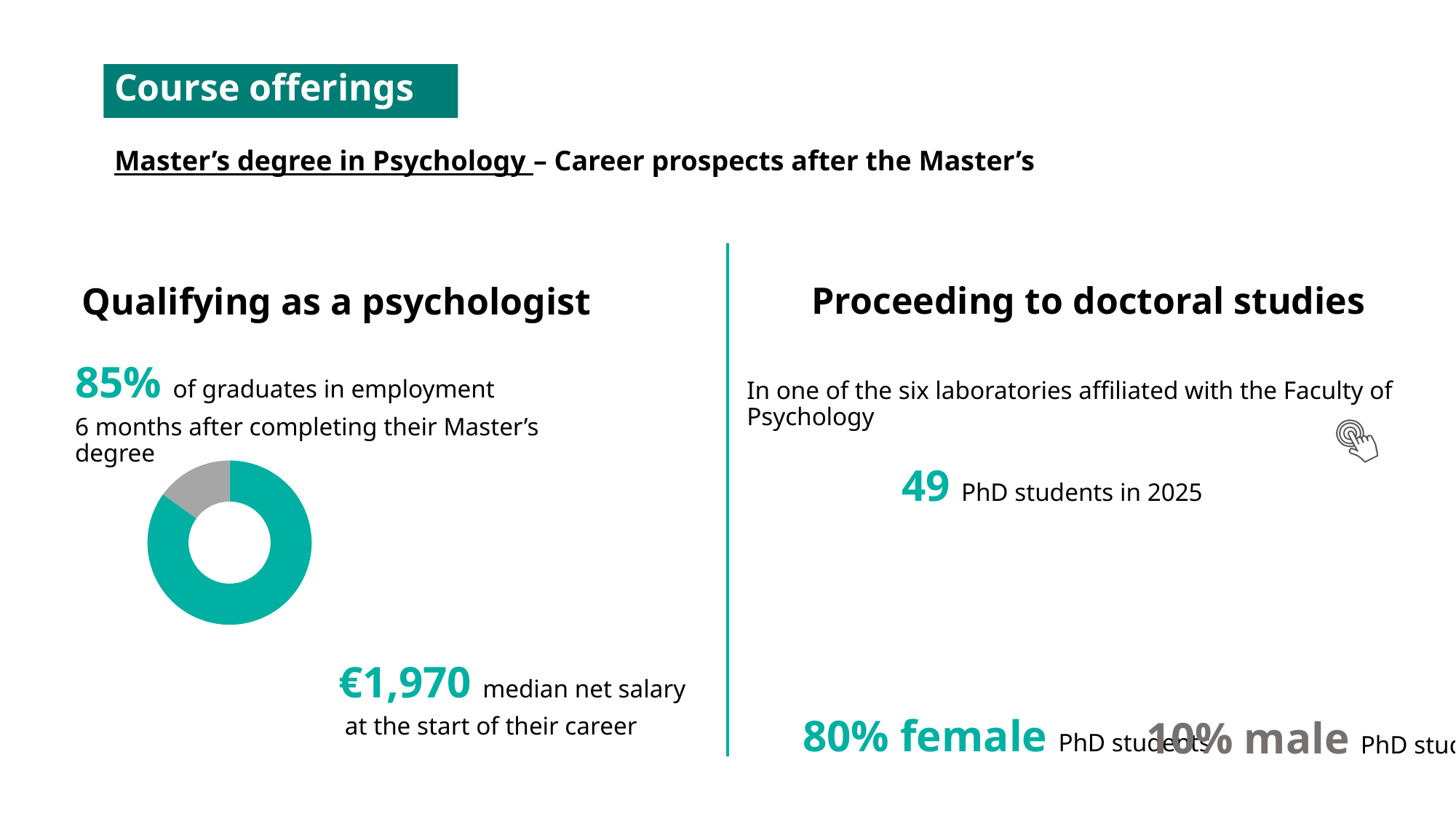
What kind of chart is shown on the left side of the slide under "Qualifying as a psychologist"? Pie chart (donut) Is the grey slice of the donut chart on the left side of the slide greater or less than 50% of the whole? less In the donut chart on the left side of the slide, which slice is larger, the teal one or the grey one? The teal one What does the teal slice of the donut chart on the left side of the slide represent, according to the text beside it? Graduates in employment 6 months after completing their Master's degree How many slices does the donut chart on the left side of the slide have? 2 In the donut chart on the left side of the slide, what share does the teal slice represent, according to the figure printed beside it? 85% Is the teal slice of the donut chart on the left side of the slide greater or less than 50% of the whole? greater What colour is the larger slice of the donut chart on the left side of the slide? Teal